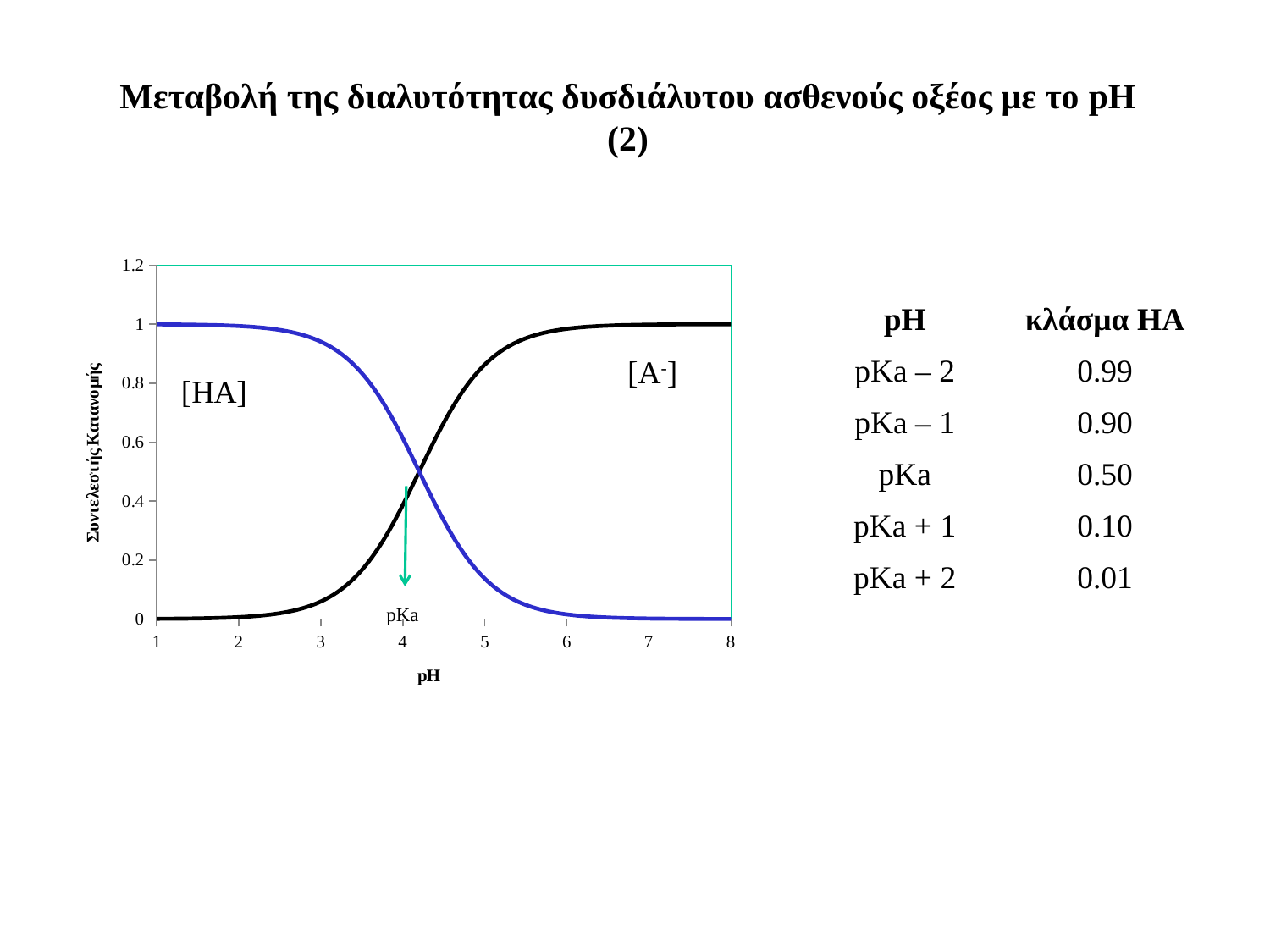
How many curves are plotted on the chart? 2 At pH 3, which curve has the larger value, [HA] or [A-]? [HA] Does the [HA] curve rise or fall as pH increases? fall Is the value of the [HA] curve at pH 5 greater or less than 0.4? less Is the value of the [HA] curve at pH 3 greater or less than 0.8? greater What is the value of the [A-] curve at pH 1? 0 What is the value of the [A-] curve at pH 8? 1 What is the label of the x axis of the chart? pH What is the value of the [HA] curve at pH 1? 1 Is the value of the [A-] curve at pH 6 greater or less than 0.8? greater What kind of chart is shown on the slide? line chart Near which pH value is the pKa arrow marked on the chart? 4